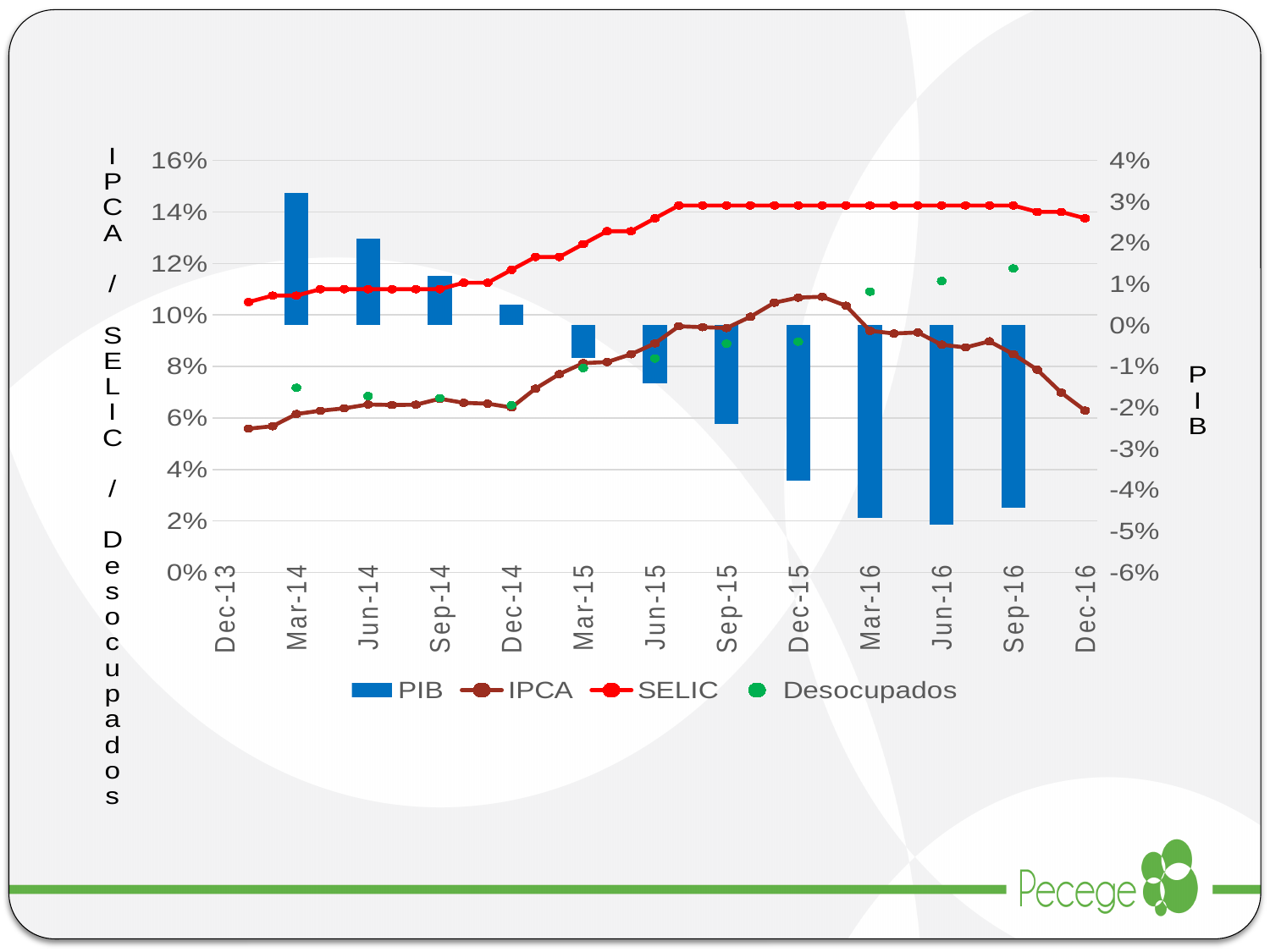
How many series does the legend list? 4 Is the IPCA value for Dec-13 greater or less than 6%? less Does the SELIC line rise or fall from Dec-13 to Jun-15? rise Is the PIB value for Jun-16 greater or less than -4%? less Which date has the lowest PIB bar? Jun-16 How many dates are labelled on the x axis? 13 Is the PIB value for Mar-14 greater or less than 2%? greater Which is larger at Dec-13, SELIC or IPCA? SELIC Which date has the highest PIB bar? Mar-14 Which date has the highest Desocupados point? Sep-16 What kind of chart is this? Combined bar and line chart